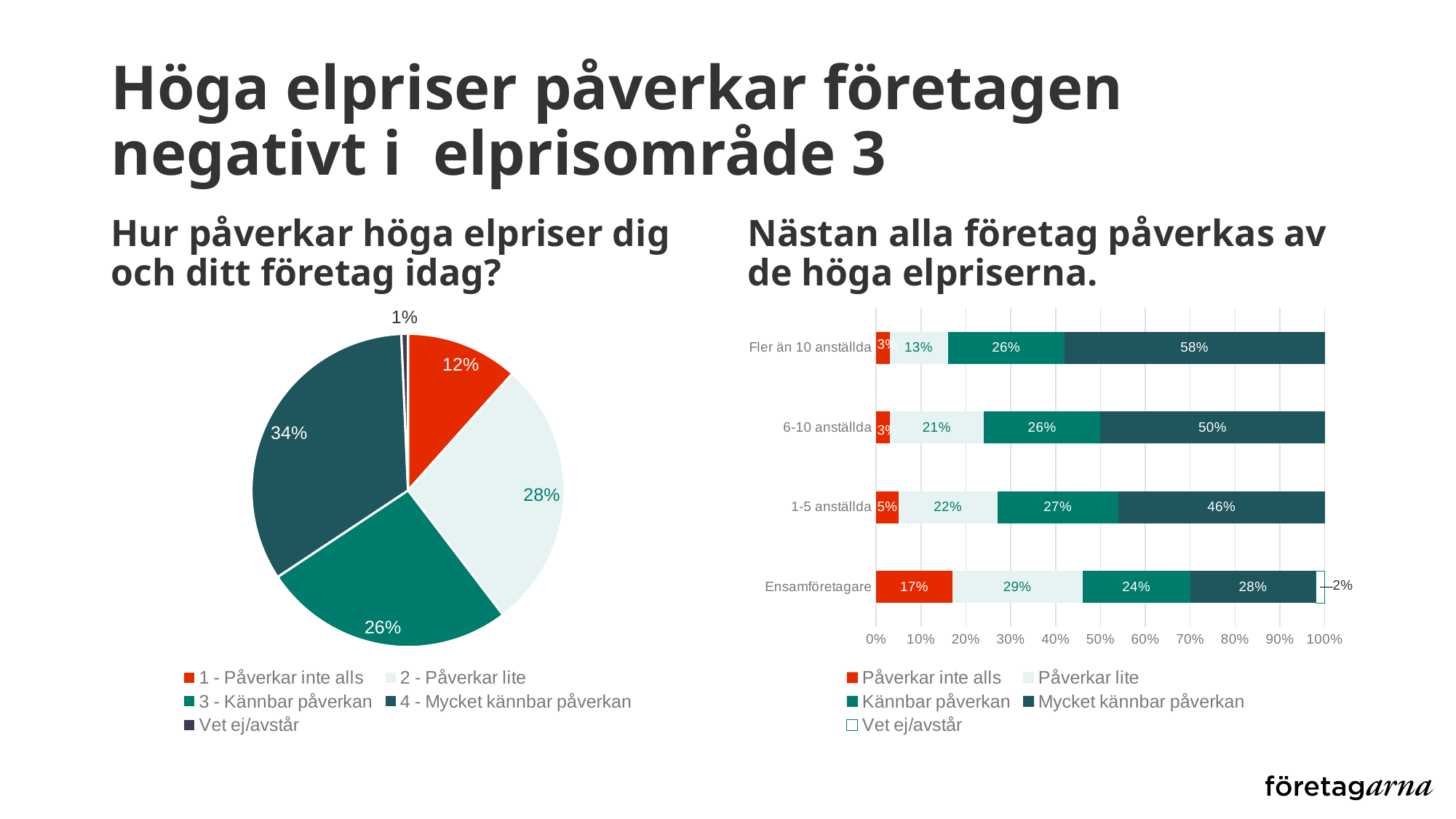
In the pie chart on the left, which category has the largest slice? 4 - Mycket kännbar påverkan In the pie chart on the left, which category has the smallest slice? Vet ej/avstår How many series does the legend of the bar chart on the right list? 5 In the bar chart on the right, what is the difference between "Mycket kännbar påverkan" for "6-10 anställda" and for "1-5 anställda"? 4% In the bar chart on the right, which is larger: "Påverkar lite" for "6-10 anställda" or "Påverkar lite" for "Fler än 10 anställda"? 6-10 anställda In the pie chart on the left, what is the difference between the shares for "2 - Påverkar lite" and "1 - Påverkar inte alls"? 16% In the bar chart on the right, what is the value of "Mycket kännbar påverkan" for "Fler än 10 anställda"? 58% In the bar chart on the right, which group has the highest value for "Mycket kännbar påverkan"? Fler än 10 anställda How many categories does the legend of the pie chart on the left list? 5 In the bar chart on the right, what is the value of "Påverkar inte alls" for "Ensamföretagare"? 17% In the pie chart on the left, what share of respondents answered "4 - Mycket kännbar påverkan"? 34% What kind of chart is the chart on the right, "Nästan alla företag påverkas av de höga elpriserna"? Stacked bar chart